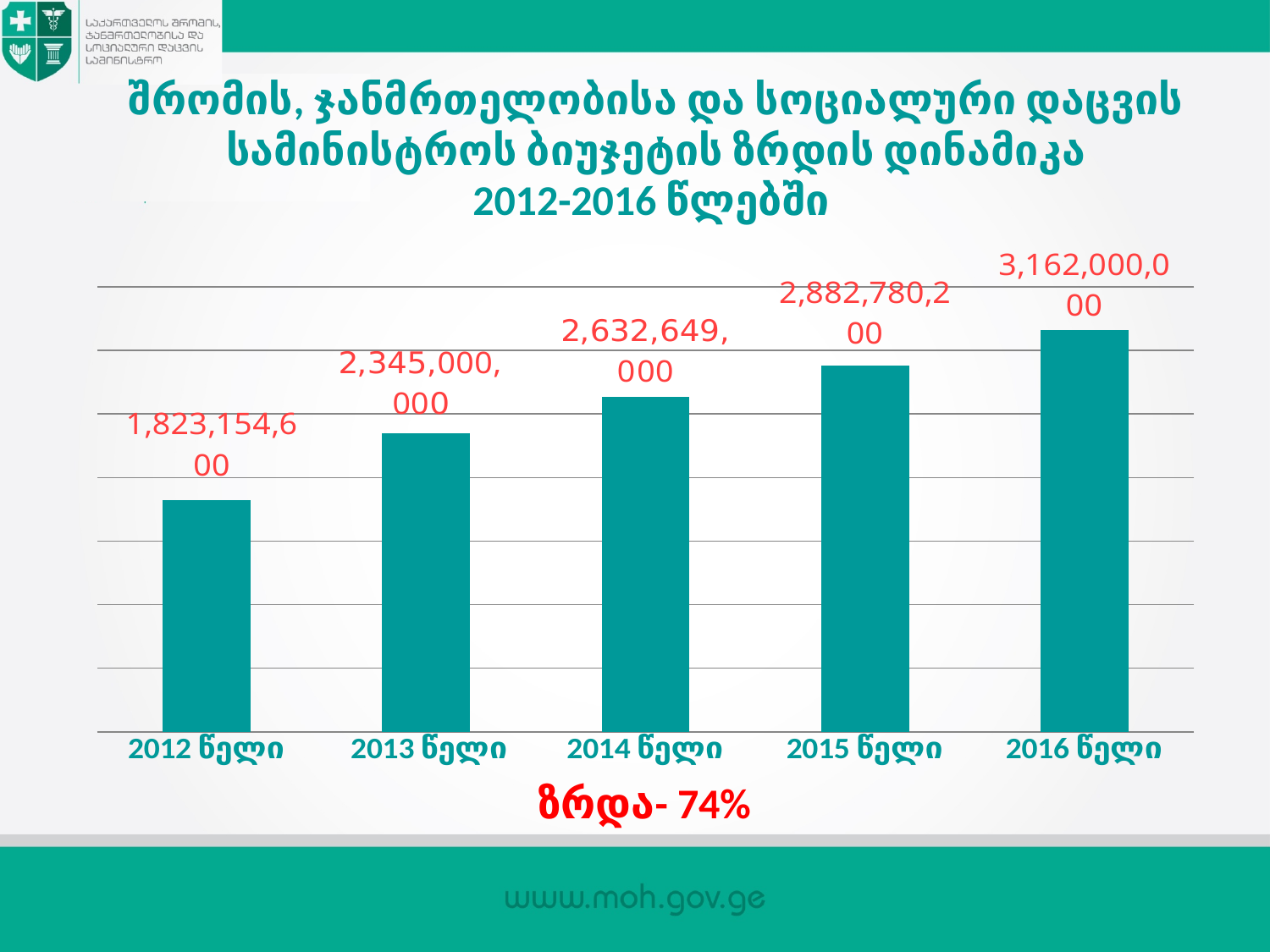
Which year has the highest value? 2016 წელი Which is larger, the value for 2013 or the value for 2015? 2015 წელი What kind of chart is shown on the slide? Bar chart What is the difference between the values for 2016 and 2012? 1,338,845,400 What is the value for 2014 (2014 წელი)? 2,632,649,000 What is the value for 2015 (2015 წელი)? 2,882,780,200 How many years (bars) are shown in the chart? 5 Which year has the lowest value? 2012 წელი What is the value for 2012 (2012 წელი)? 1,823,154,600 What is the difference between the values for 2013 and 2012? 521,845,400 What is the value for 2016 (2016 წელი)? 3,162,000,000 Do the values rise or fall from 2012 to 2016? Rise